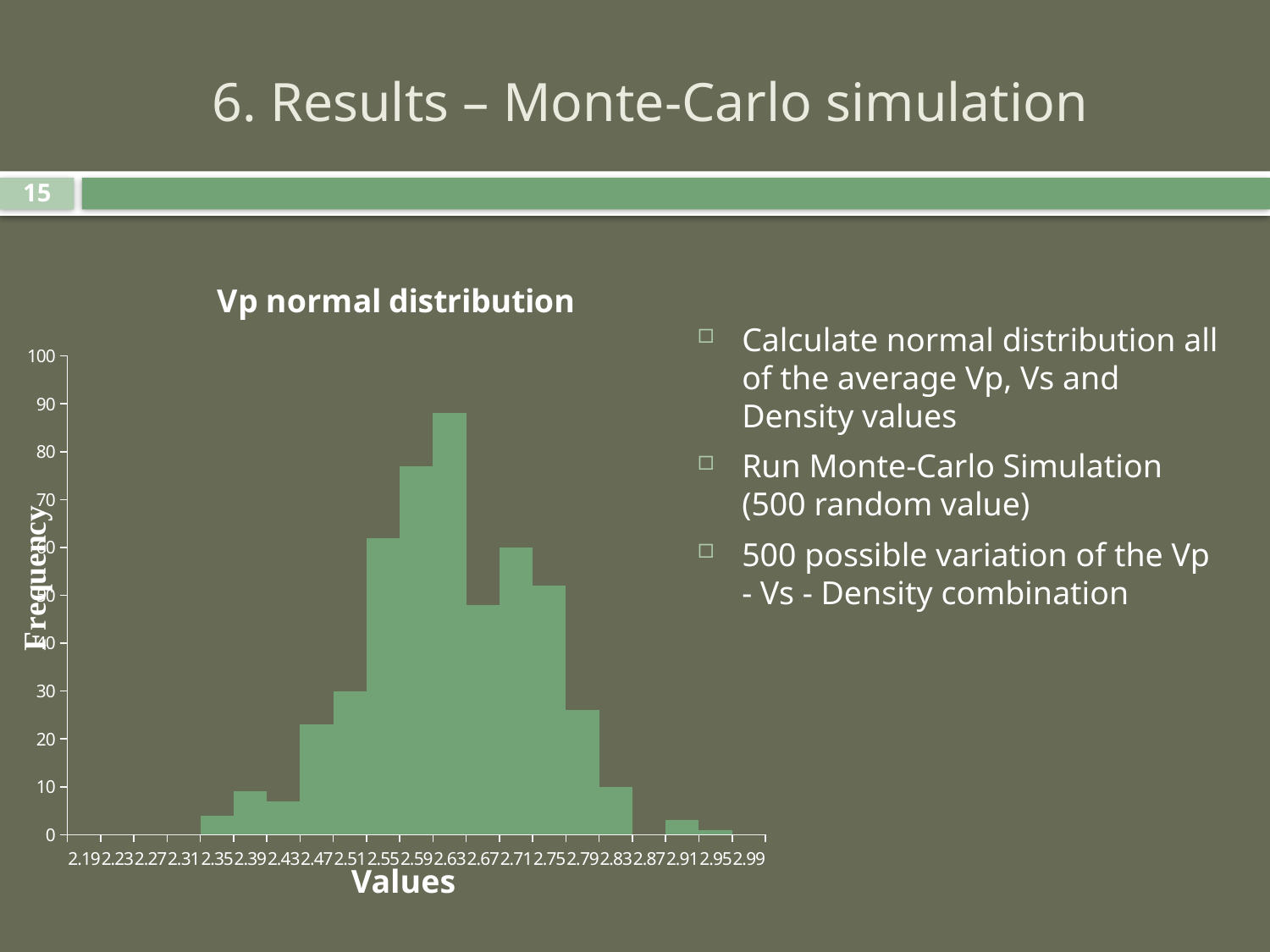
Is the frequency for 2.79 greater or less than 40? less Which has the higher frequency, 2.59 or 2.71? 2.59 Is the frequency for 2.47 greater or less than 30? less Which has the higher frequency, 2.55 or 2.67? 2.55 Is the frequency for 2.63 greater or less than 80? greater Do the frequencies rise or fall along the x axis from 2.35 to 2.63? rise How many tick labels are shown on the x axis of the chart? 21 What is the label of the vertical axis of the chart? Frequency What is the title of the chart? Vp normal distribution What kind of chart is shown on the slide? bar chart Which value on the x axis has the highest frequency? 2.63